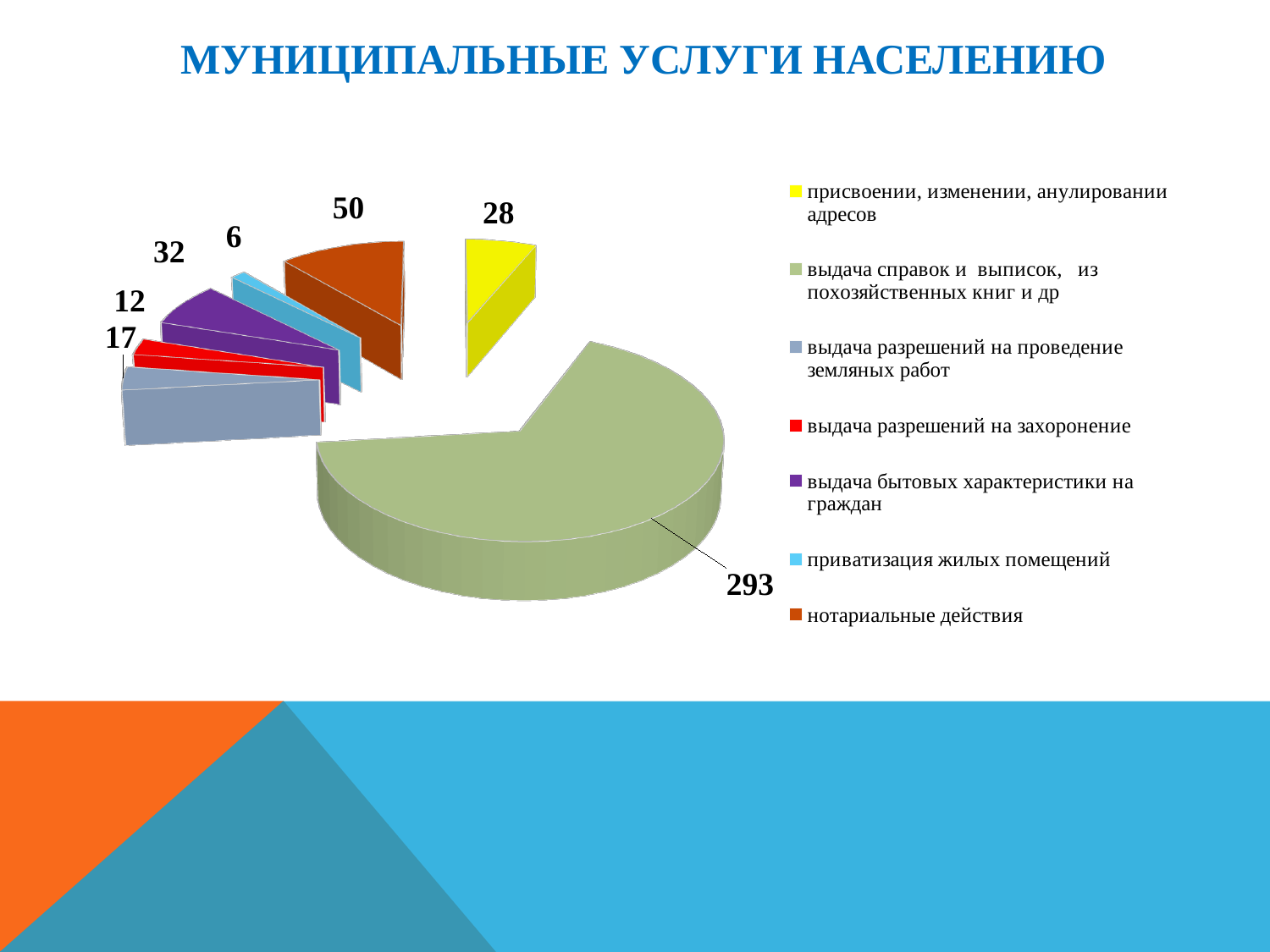
What is the value for "выдача разрешений на захоронение"? 12 What is the value for "приватизация жилых помещений"? 6 What type of chart is shown on the slide? pie chart What is the difference between the values for "нотариальные действия" and "выдача бытовых характеристики на граждан"? 18 Which is larger: the value for "выдача разрешений на проведение земляных работ" or the value for "выдача разрешений на захоронение"? выдача разрешений на проведение земляных работ Which category has the smallest slice of the pie? приватизация жилых помещений Which category has the largest slice of the pie? выдача справок и выписок, из похозяйственных книг и др What is the title of the slide? МУНИЦИПАЛЬНЫЕ УСЛУГИ НАСЕЛЕНИЮ What is the value for "присвоении, изменении, анулировании адресов"? 28 What is the value for "нотариальные действия"? 50 What is the value for "выдача справок и выписок, из похозяйственных книг и др"? 293 How many slices does the pie chart have? 7